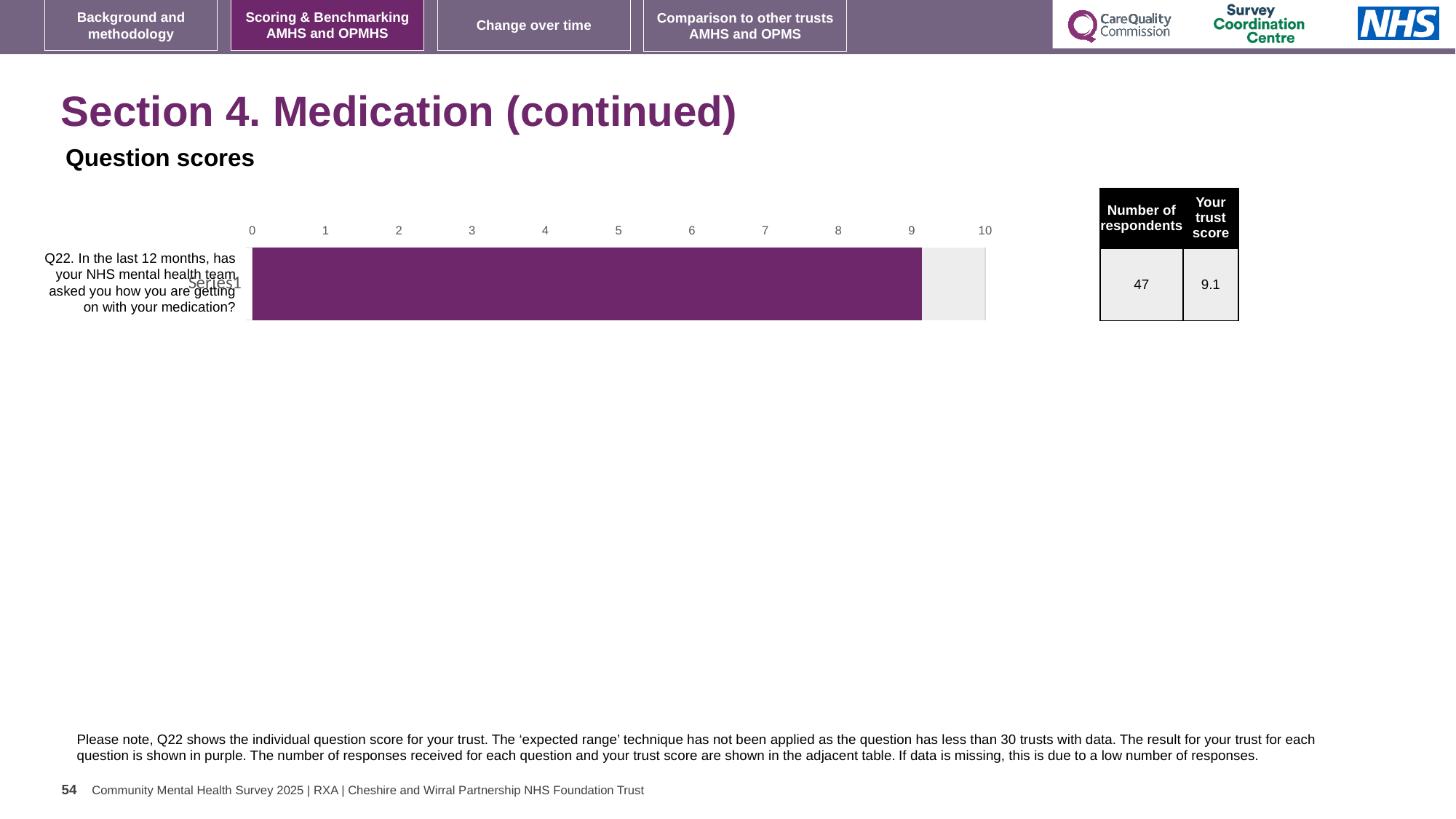
Is the value of the bar for Q22 greater or less than 8? greater What colour is the bar for Q22? purple What kind of chart is shown on the slide? bar chart What is the trust score for Q22 shown in the adjacent table? 9.1 What is the highest value shown on the chart's axis? 10 How many bars are plotted in the chart? 1 Is the value of the bar for Q22 greater or less than 5? greater Which question number does the bar in the chart represent? Q22 How many respondents are shown for Q22 in the adjacent table? 47